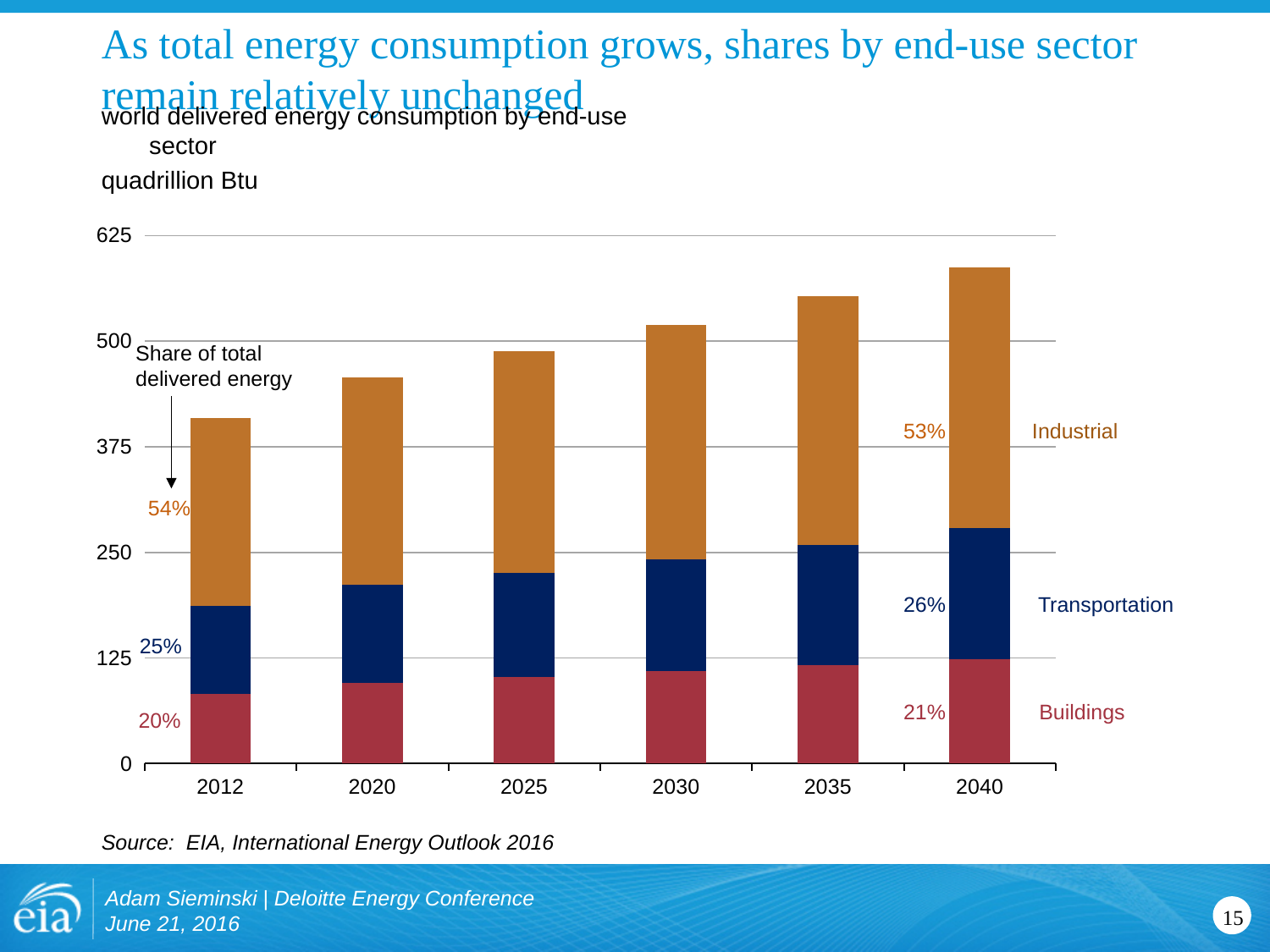
What share of total delivered energy does the Transportation sector have in 2012? 25% What share of total delivered energy does the Industrial sector have in 2040? 53% How many years are shown on the x axis of the chart? 6 What share of total delivered energy does the Buildings sector have in 2040? 21% In what unit is energy consumption measured on the chart? quadrillion Btu Does total delivered energy consumption rise or fall from 2012 to 2040? rise What share of total delivered energy does the Industrial sector have in 2012? 54% How many end-use sectors (series) are shown in the chart? 3 What kind of chart is shown on the slide? stacked bar chart Is the total delivered energy consumption for 2040 greater or less than 500 quadrillion Btu? greater Is the total delivered energy consumption for 2012 greater or less than 500 quadrillion Btu? less Which year has the highest total delivered energy consumption? 2040